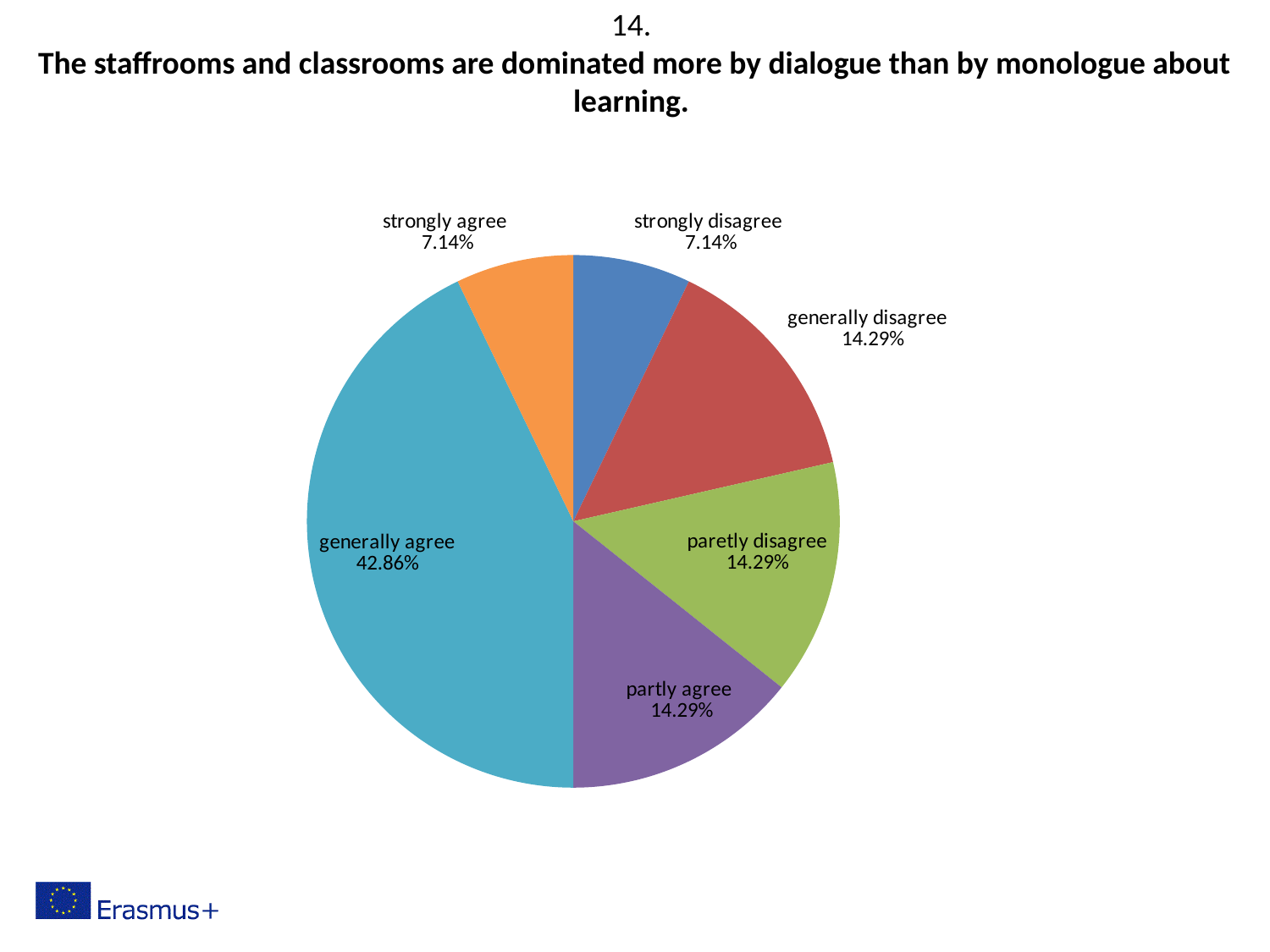
How many slices does the pie chart have? 6 What percentage is shown for 'strongly disagree'? 7.14% What is the number shown above the chart title on the slide? 14. Which is larger, the 'generally disagree' slice or the 'strongly agree' slice? generally disagree What percentage is shown for 'partly agree'? 14.29% What share of the pie is labelled 'generally agree'? 42.86% What is the difference between the 'generally agree' share and the 'partly agree' share? 28.57% What percentage is shown for 'generally disagree'? 14.29% What colour is the 'generally agree' slice? light blue What kind of chart is shown on the slide? pie chart What is the combined share of 'strongly agree' and 'generally agree'? 50% Which category has the largest slice of the pie? generally agree